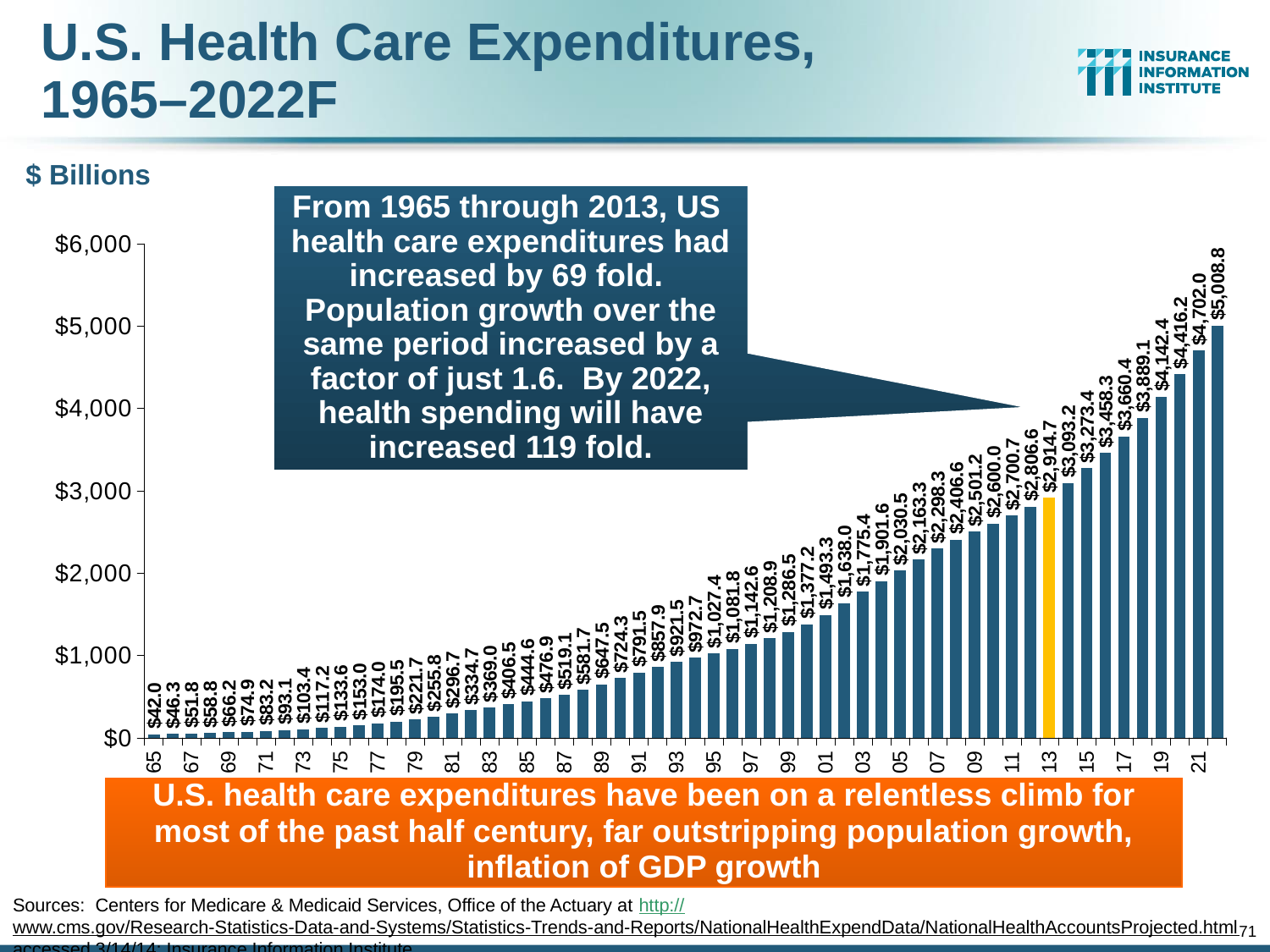
Which year has the lowest health care expenditure? 1965 Do the values rise or fall from 1965 to 2022? Rise What is the value for 2013, the highlighted bar? $2,914.7 How many bars (years) are plotted in the chart? 58 What is the value for 2022F, the last bar? $5,008.8 What kind of chart is shown on the slide? Bar chart What unit is shown above the y axis of the chart? $ Billions What is the difference between the 2022F value and the 2013 value? $2,094.1 Which is larger, the value for 1995 or the value for 2001? 2001 Which year has the highest health care expenditure? 2022 What is the value for 2005? $2,030.5 What is the value for 1965, the first bar? $42.0